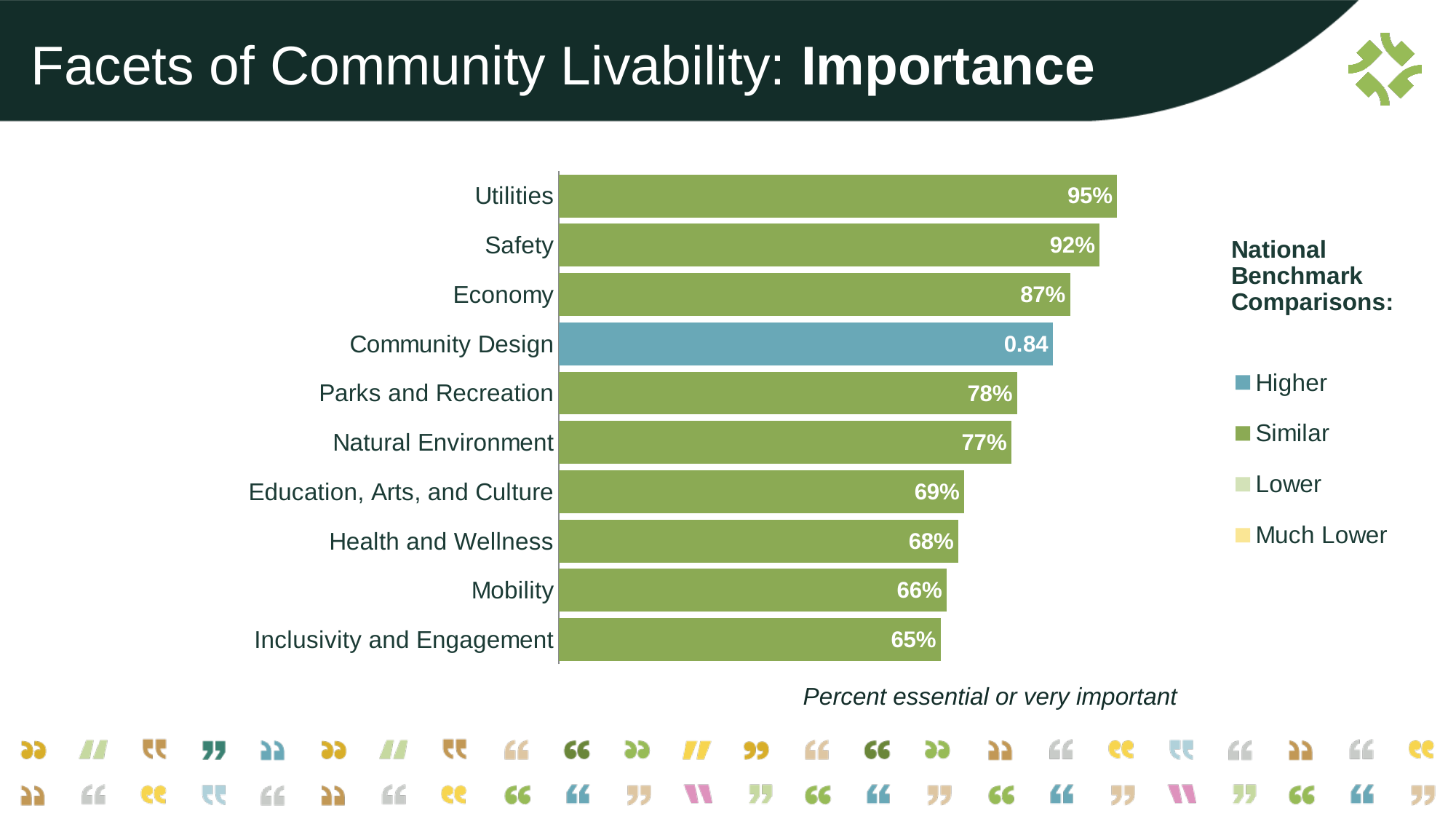
Which category has the highest value? Utilities What is the difference between the values for Utilities and Mobility? 29% What is the value for Utilities? 95% Which category's bar is coloured blue, indicating a 'Higher' national benchmark comparison? Community Design How many categories are shown in the chart? 10 What is the difference between the values for Safety and Economy? 5% Which category has the lowest value? Inclusivity and Engagement How many entries does the legend list? 4 What is the value for Parks and Recreation? 78% Which is larger, the value for Natural Environment or the value for Health and Wellness? Natural Environment What value is printed on the bar for Community Design? 0.84 What kind of chart is shown on the slide? Bar chart